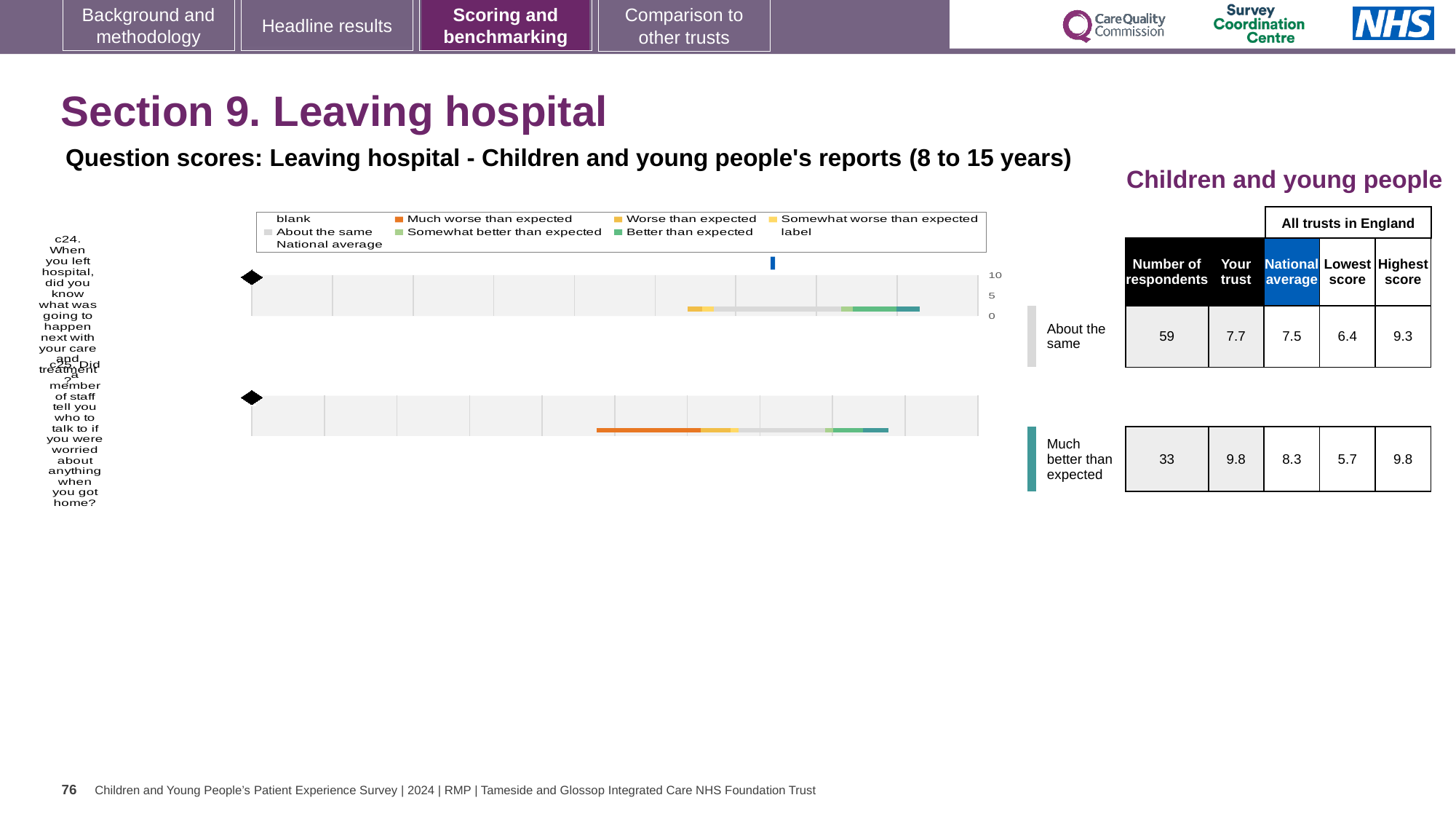
What benchmark category is shown for question c24? About the same How many respondents answered question c24? 59 How many questions (bars) are plotted in the Leaving hospital chart? 2 Which question has the higher 'Your trust' score, c24 or c25? c25 What is the lowest score among all trusts in England for question c25? 5.7 What is the national average score for question c25 (Did a member of staff tell you who to talk to if you were worried about anything when you got home?)? 8.3 What benchmark category is shown for question c25? Much better than expected By how much does the trust's score for c25 exceed the national average for c25? 1.5 What is the 'Your trust' score for question c24 (When you left hospital, did you know what was going to happen next with your care and treatment?)? 7.7 What kind of chart is used to show the question scores for Leaving hospital? bar chart How many entries does the legend of the Leaving hospital chart list? 9 What is the highest score among all trusts in England for question c24? 9.3